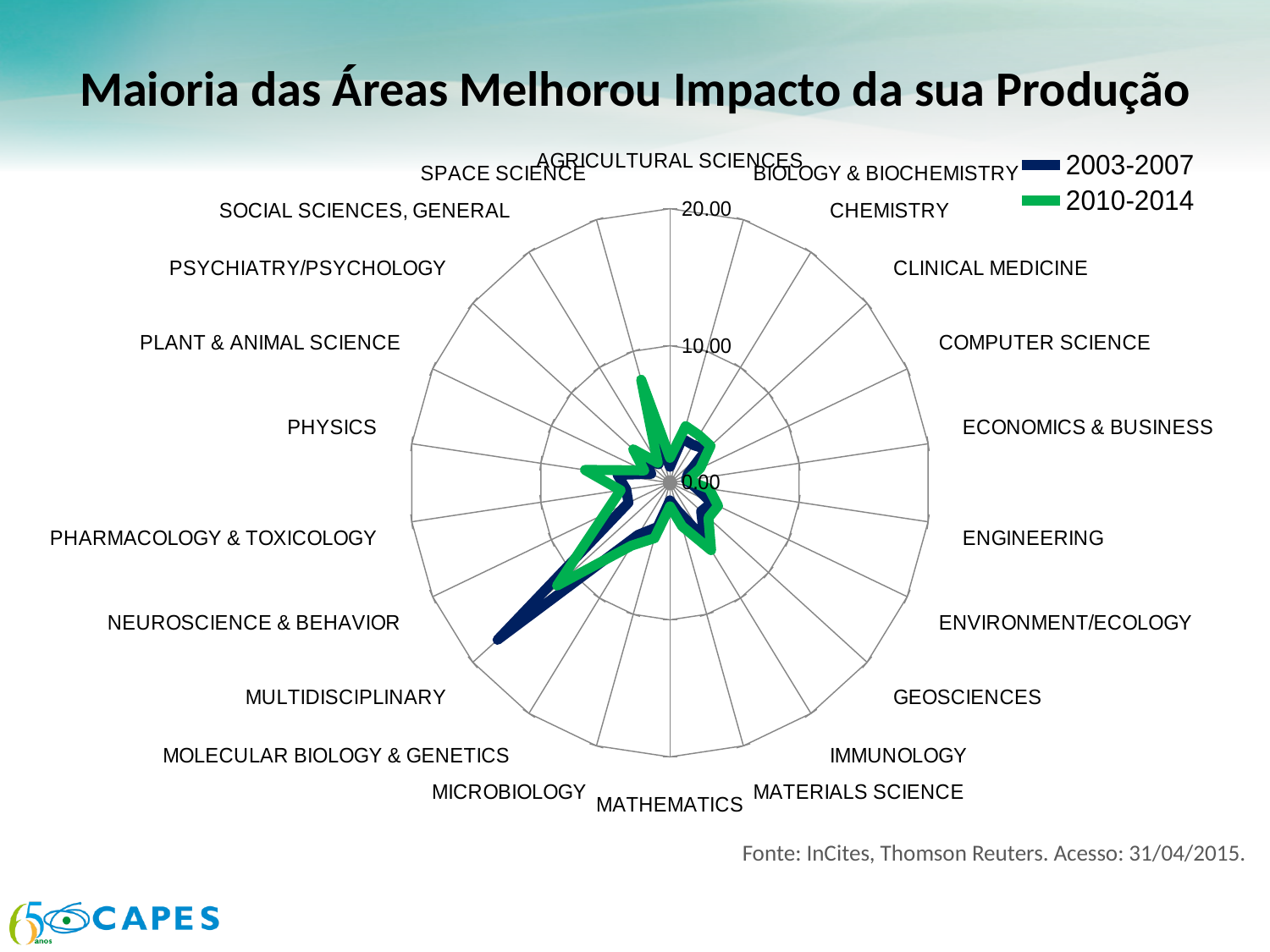
For MULTIDISCIPLINARY, which series has the larger value, 2003-2007 or 2010-2014? 2003-2007 For AGRICULTURAL SCIENCES, which series has the larger value, 2003-2007 or 2010-2014? 2010-2014 Is the 2003-2007 value for MULTIDISCIPLINARY greater or less than 10.00? greater What kind of chart is shown on the slide? Radar chart Is the 2010-2014 value for MULTIDISCIPLINARY greater or less than 10.00? greater Is the 2010-2014 value for AGRICULTURAL SCIENCES greater or less than 10.00? less Which research area has the highest value for the 2003-2007 series? MULTIDISCIPLINARY Which two periods are listed in the legend? 2003-2007 and 2010-2014 What is the highest tick value shown on the radar chart's axis? 20.00 Which research area has the highest value for the 2010-2014 series? MULTIDISCIPLINARY How many series does the legend list? 2 How many research areas (categories) are plotted on the radar chart? 22